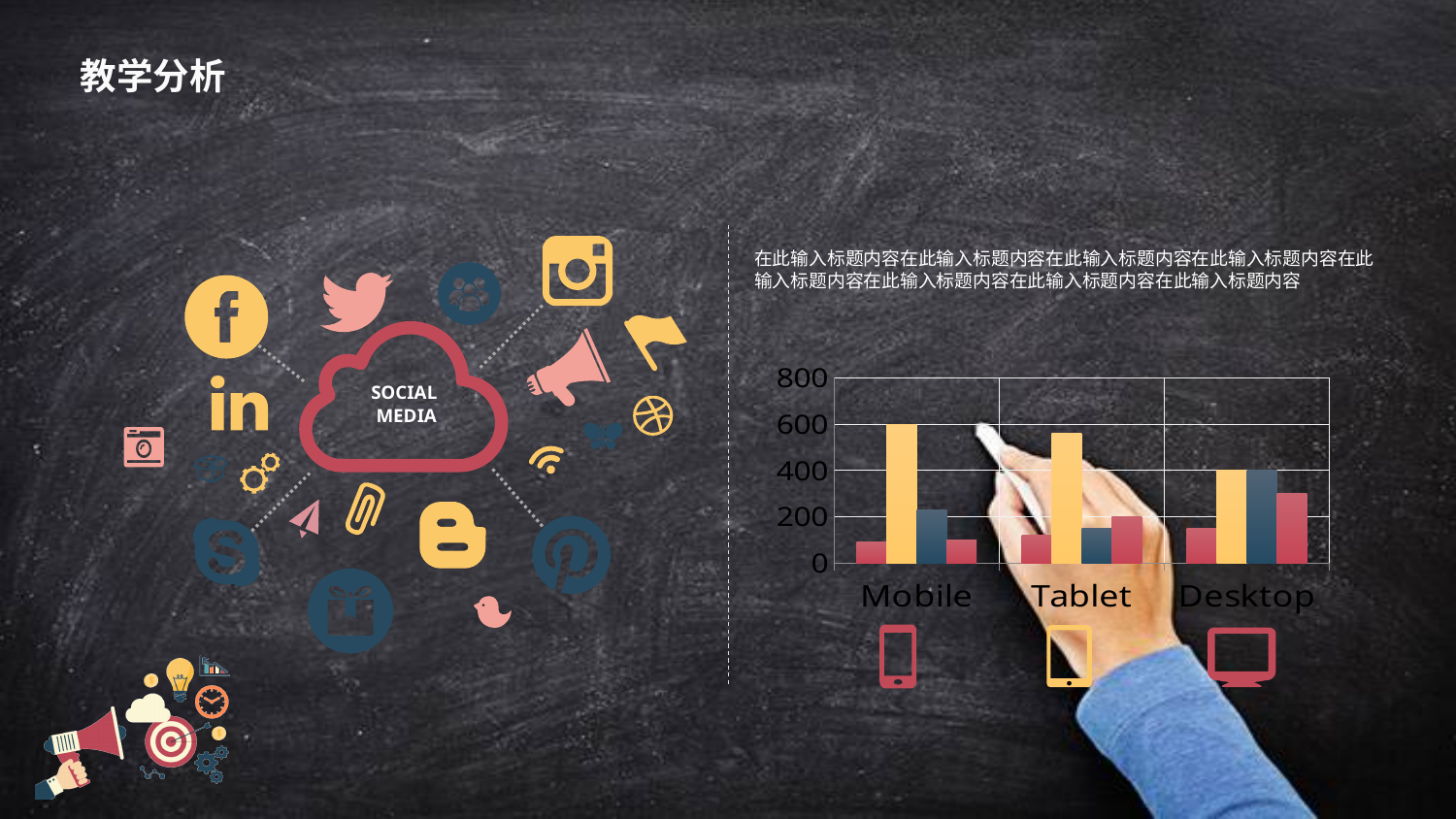
What is the highest value shown on the y axis of the chart? 800 Is the tallest bar for Mobile greater or less than 400? greater How many bars are plotted for each category in the chart? 4 What are the category labels on the x axis of the chart? Mobile, Tablet, Desktop Is the shortest bar for Desktop greater or less than 200? less Which has the taller tallest bar, Mobile or Desktop? Mobile Which category contains the tallest bar in the chart? Mobile Is the shortest bar for Mobile greater or less than 200? less What kind of chart is shown on the slide? bar chart How many categories are shown on the x axis of the chart? 3